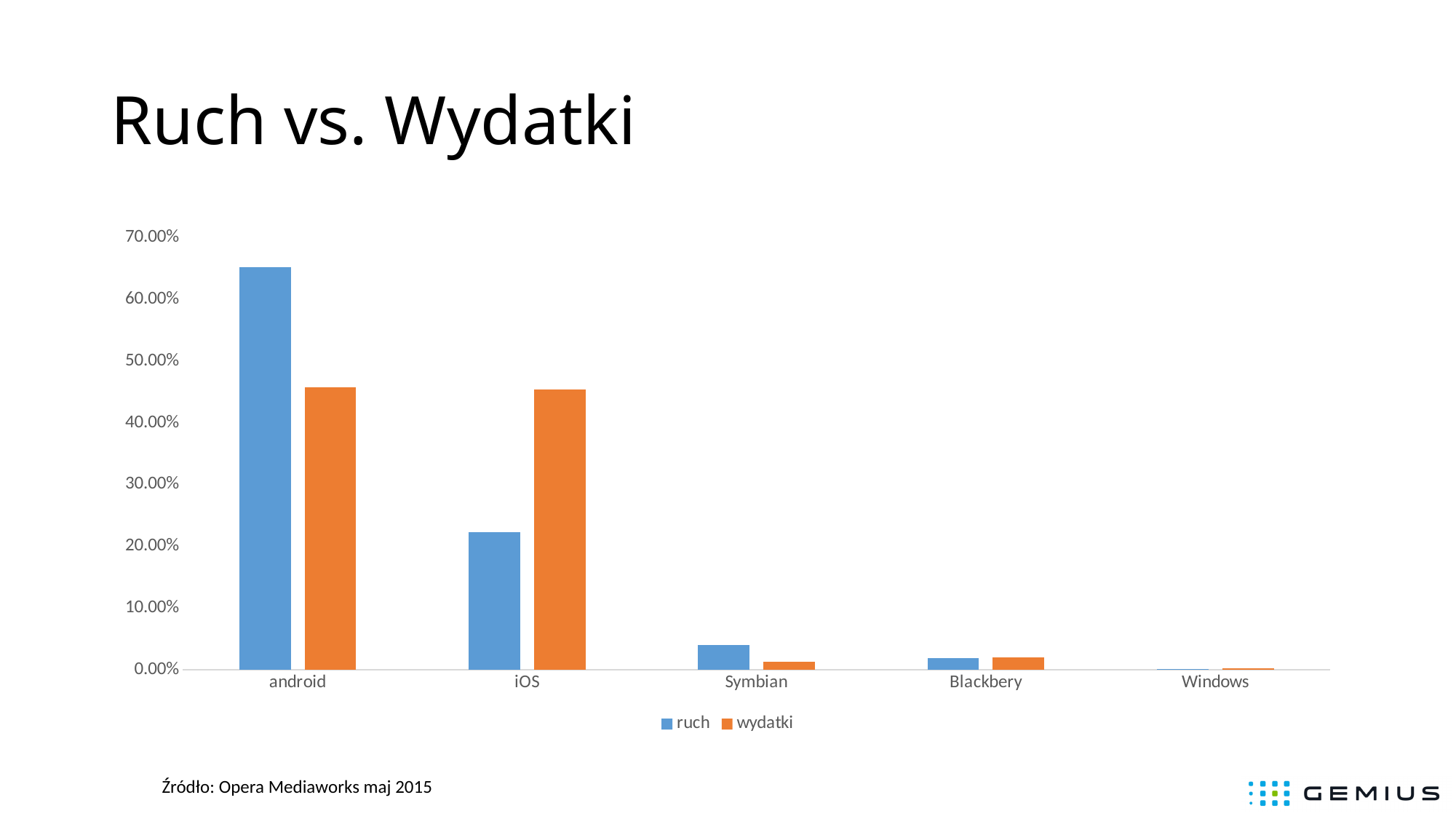
How many series does the legend list? 2 For Symbian, which series has the larger value, ruch or wydatki? ruch Is the wydatki value for android greater or less than 50.00%? less What kind of chart is shown on the slide? bar chart Which category has the lowest value for the wydatki series? Windows What is the title of the slide? Ruch vs. Wydatki Which category has the highest value for the ruch series? android Is the ruch value for iOS greater or less than 20.00%? greater Which category has the lowest value for the ruch series? Windows How many categories are shown on the x axis? 5 For iOS, which series has the larger value, ruch or wydatki? wydatki Is the ruch value for android greater or less than 60.00%? greater